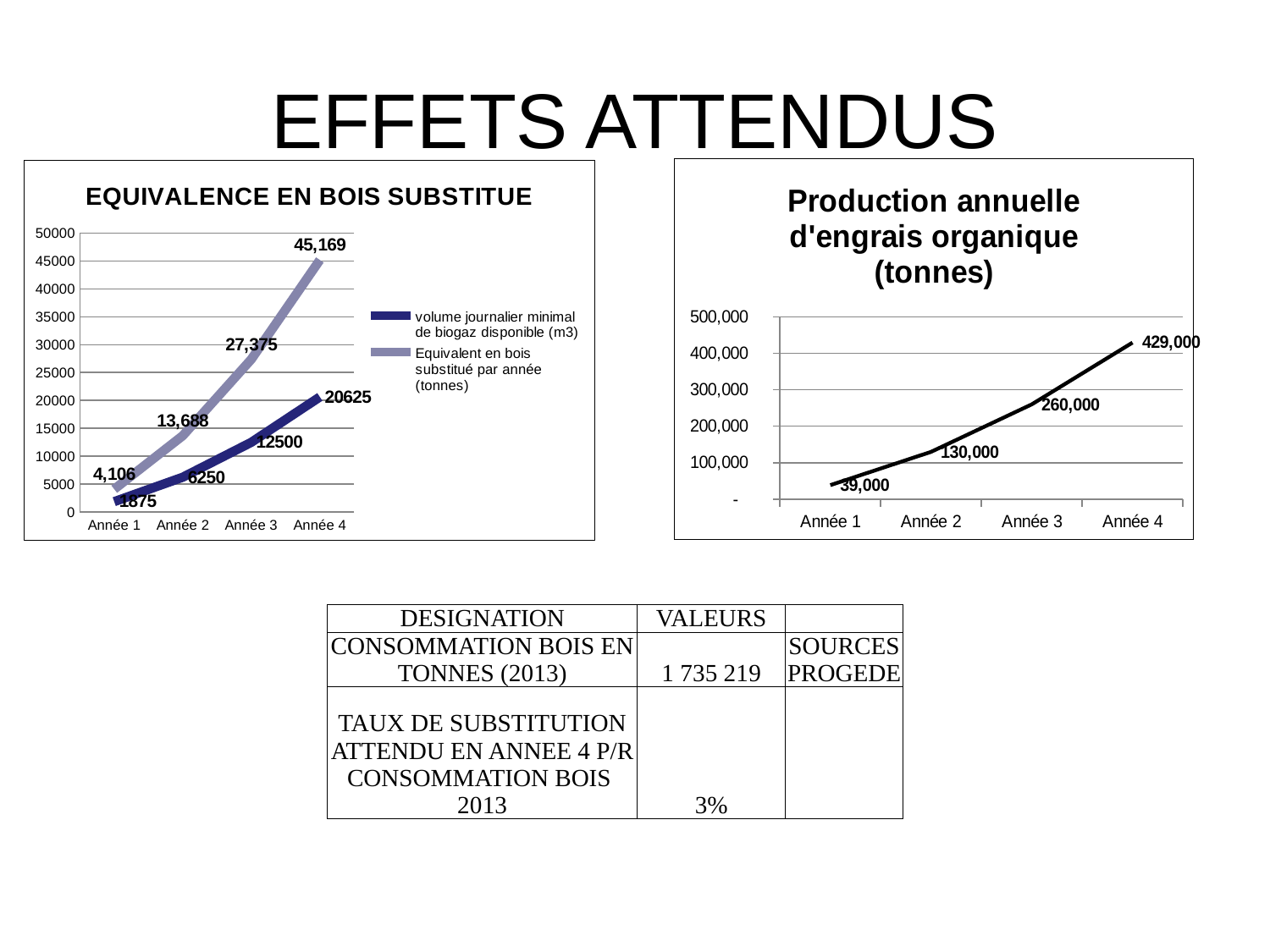
In the chart titled 'EQUIVALENCE EN BOIS SUBSTITUE', which is larger in Année 2: 'volume journalier minimal de biogaz disponible (m3)' or 'Equivalent en bois substitué par année (tonnes)'? Equivalent en bois substitué par année (tonnes) In the chart titled 'Production annuelle d'engrais organique (tonnes)', what is the value for Année 1? 39,000 In the chart titled 'EQUIVALENCE EN BOIS SUBSTITUE', what is the value of 'volume journalier minimal de biogaz disponible (m3)' for Année 3? 12500 In the chart titled 'Production annuelle d'engrais organique (tonnes)', what is the value for Année 4? 429,000 In the chart titled 'Production annuelle d'engrais organique (tonnes)', how many years are plotted? 4 In the chart titled 'EQUIVALENCE EN BOIS SUBSTITUE', which year has the lowest value for 'Equivalent en bois substitué par année (tonnes)'? Année 1 In the chart titled 'Production annuelle d'engrais organique (tonnes)', do the values rise or fall from Année 1 to Année 4? rise In the chart titled 'EQUIVALENCE EN BOIS SUBSTITUE', how many series does the legend list? 2 In the chart titled 'EQUIVALENCE EN BOIS SUBSTITUE', what is the difference between the 'Equivalent en bois substitué par année (tonnes)' values for Année 4 and Année 3? 17,794 In the chart titled 'EQUIVALENCE EN BOIS SUBSTITUE', what is the value of 'Equivalent en bois substitué par année (tonnes)' for Année 4? 45,169 What kind of chart is the chart titled 'EQUIVALENCE EN BOIS SUBSTITUE'? line chart In the chart titled 'Production annuelle d'engrais organique (tonnes)', what is the difference between the values for Année 3 and Année 2? 130,000